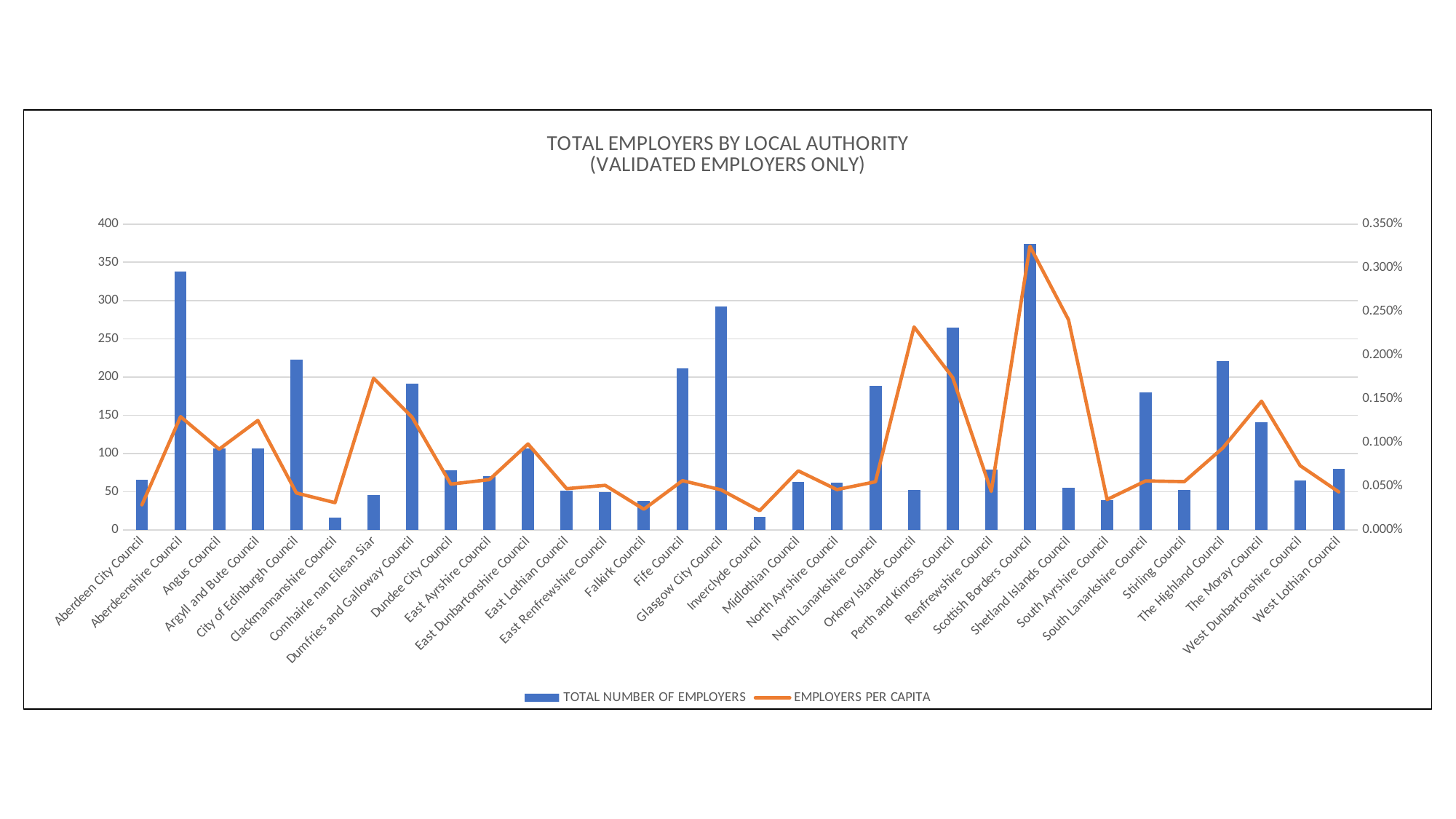
What is the title of the chart? TOTAL EMPLOYERS BY LOCAL AUTHORITY (VALIDATED EMPLOYERS ONLY) Which local authority has the highest total number of employers? Scottish Borders Council Is the total number of employers for Glasgow City Council greater or less than 250? greater Is the employers per capita value for Orkney Islands Council greater or less than 0.200%? greater Which has more total employers, Aberdeenshire Council or Glasgow City Council? Aberdeenshire Council How many local authorities are shown on the x axis? 32 Which local authority has the highest employers per capita? Scottish Borders Council How many series does the legend list? 2 What kind of chart is shown on the slide? A combination bar and line chart Is the total number of employers for Aberdeenshire Council greater or less than 300? greater Which has more total employers, Perth and Kinross Council or Fife Council? Perth and Kinross Council